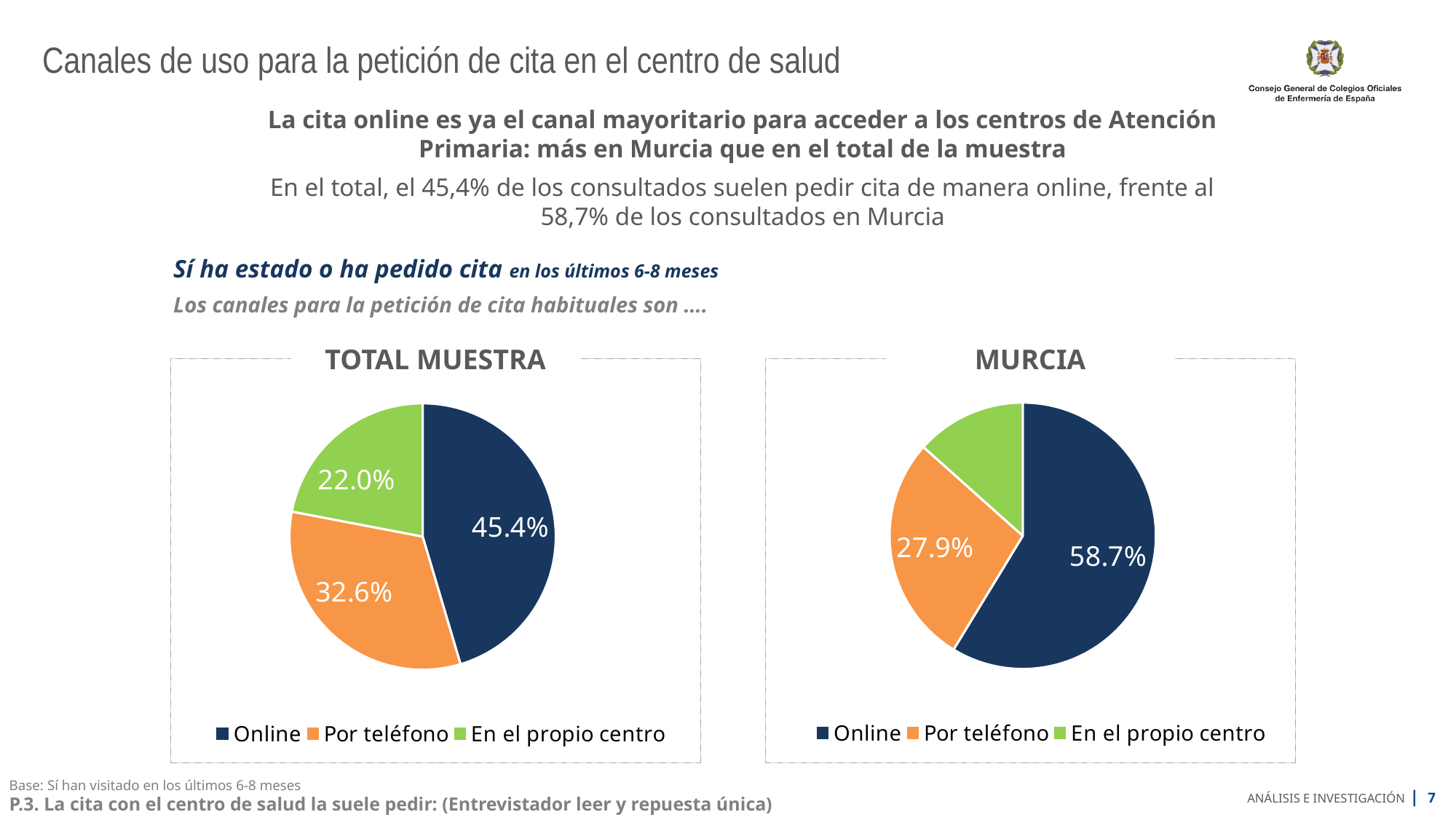
In the TOTAL MUESTRA chart, what is the value for Por teléfono? 32.6% In the TOTAL MUESTRA chart, which channel has the smallest share? En el propio centro How many categories does the legend of the MURCIA chart list? 3 What type of chart is used for TOTAL MUESTRA? Pie chart In the MURCIA chart, what is the value for Por teléfono? 27.9% What is the difference between the Online share in the MURCIA chart and the Online share in the TOTAL MUESTRA chart? 13.3 percentage points In the MURCIA chart, what percentage of respondents request appointments Online? 58.7% In the TOTAL MUESTRA chart, what is the value for En el propio centro? 22.0% In the MURCIA chart, which channel has the largest share? Online In the TOTAL MUESTRA chart, what percentage of respondents request appointments Online? 45.4% Which is larger: Por teléfono in the TOTAL MUESTRA chart or Por teléfono in the MURCIA chart? Por teléfono in the TOTAL MUESTRA chart In the TOTAL MUESTRA chart, what is the difference between the Online and Por teléfono shares? 12.8 percentage points